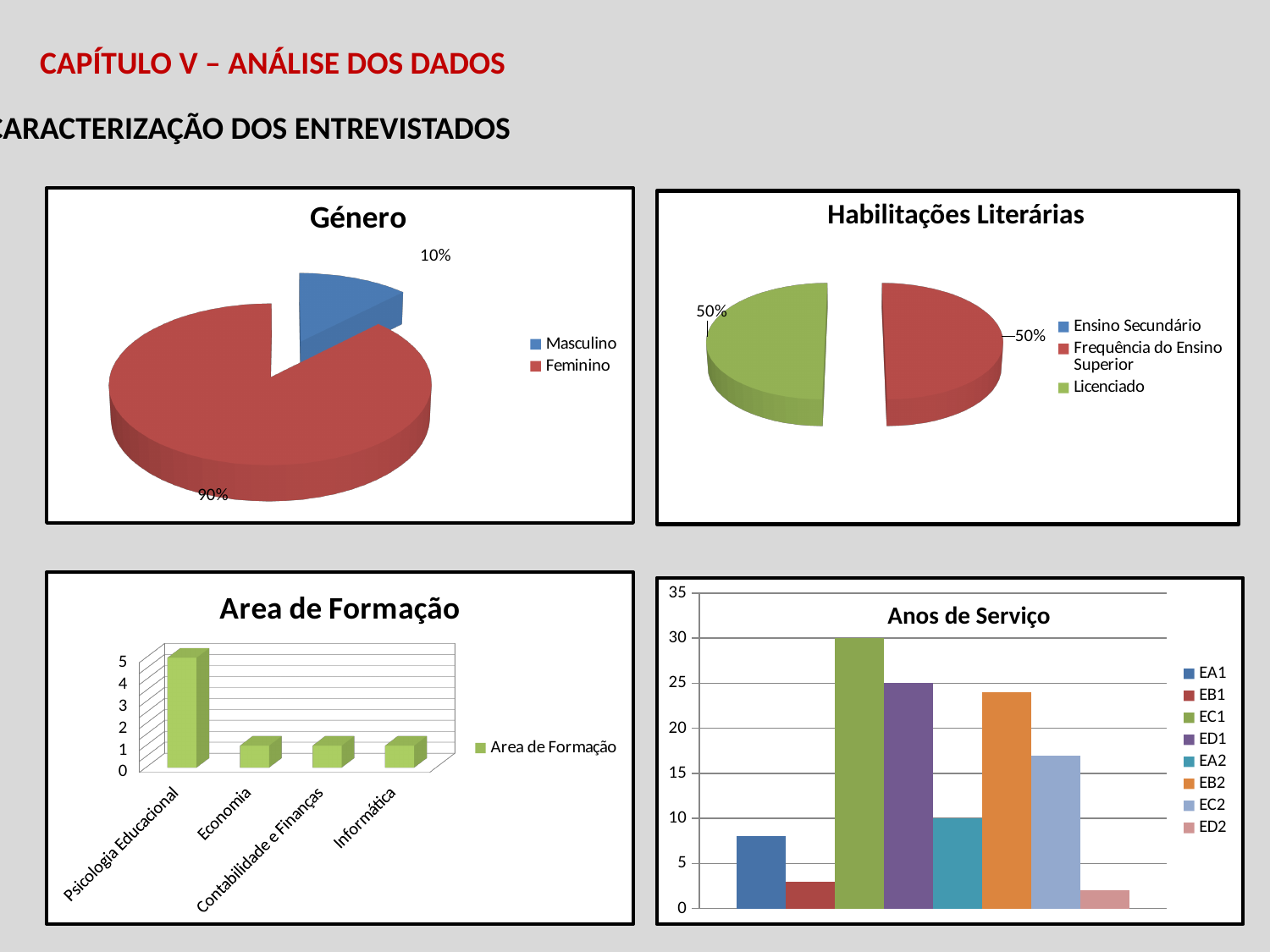
In the Anos de Serviço chart, is the value for EA1 greater or less than 10? less In the Género chart, what percentage is Masculino? 10% In the Area de Formação chart, which category has the highest value? Psicologia Educacional In the Género chart, what percentage is Feminino? 90% In the Anos de Serviço chart, what is the value for EC1? 30 In the Area de Formação chart, what is the difference between Psicologia Educacional and Economia? 4 How many categories are shown on the x axis of the Area de Formação chart? 4 In the Area de Formação chart, what is the value for Psicologia Educacional? 5 In the Anos de Serviço chart, which series has the lowest value? ED2 In the Habilitações Literárias chart, what share is Licenciado? 50% How many entries does the legend of the Habilitações Literárias chart list? 3 What kind of chart is the Género chart? pie chart